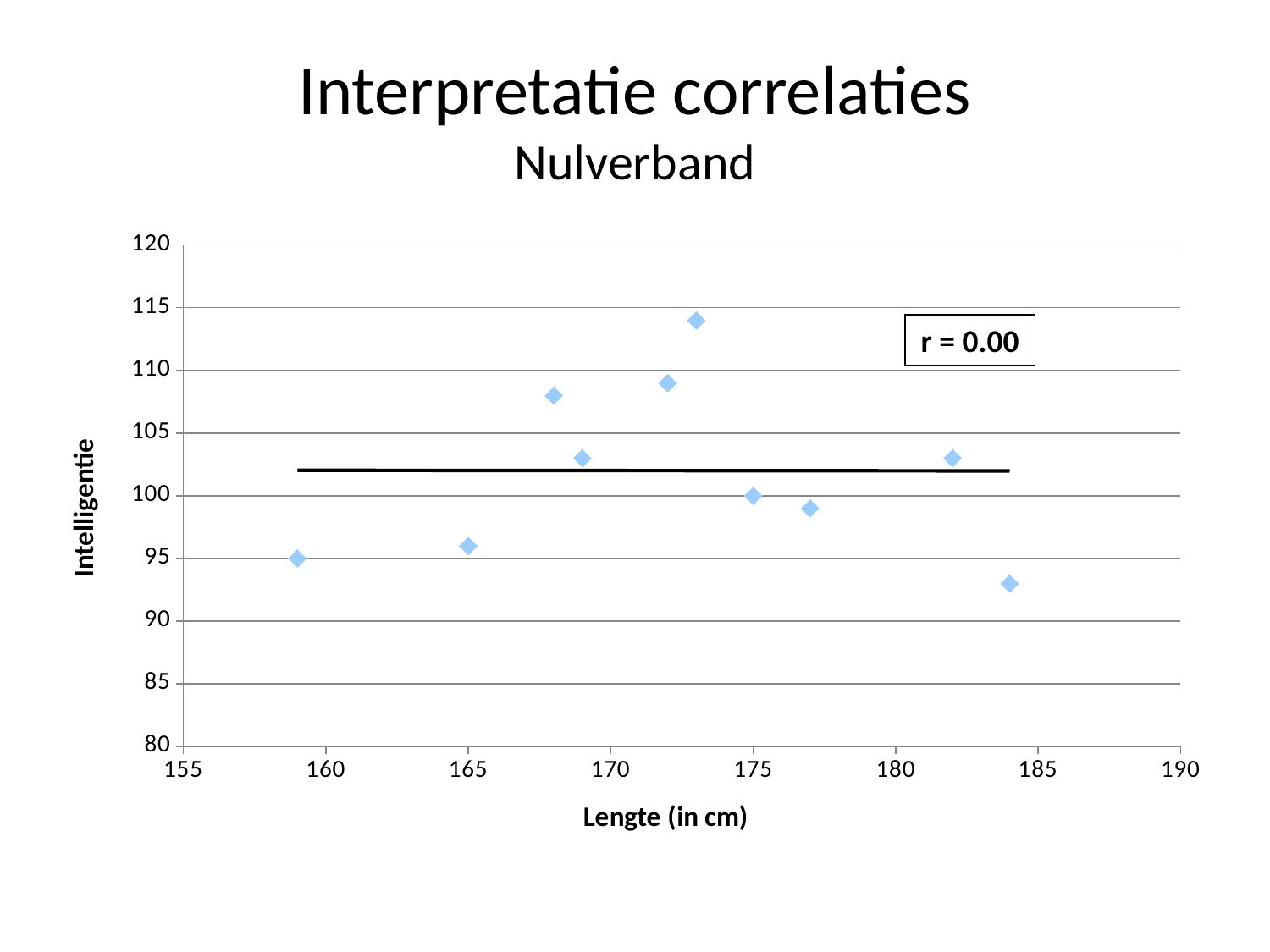
How many data points are plotted in the chart? 10 What is the title of the x axis? Lengte (in cm) Is the Intelligentie value for the point at Lengte 165 greater or less than 100? less Which point has the highest Intelligentie value: the one at Lengte 173 or the one at Lengte 172? Lengte 173 Is the Intelligentie value for the point at Lengte 173 greater or less than 110? greater Is the Intelligentie value for the point at Lengte 184 greater or less than 95? less Does the fitted line show Intelligentie rising, falling, or staying flat as Lengte increases? staying flat Which point has the lowest Intelligentie value in the chart? the point at Lengte 184 What kind of chart is shown on the slide? scatter chart What is the correlation coefficient shown in the box on the chart? r = 0.00